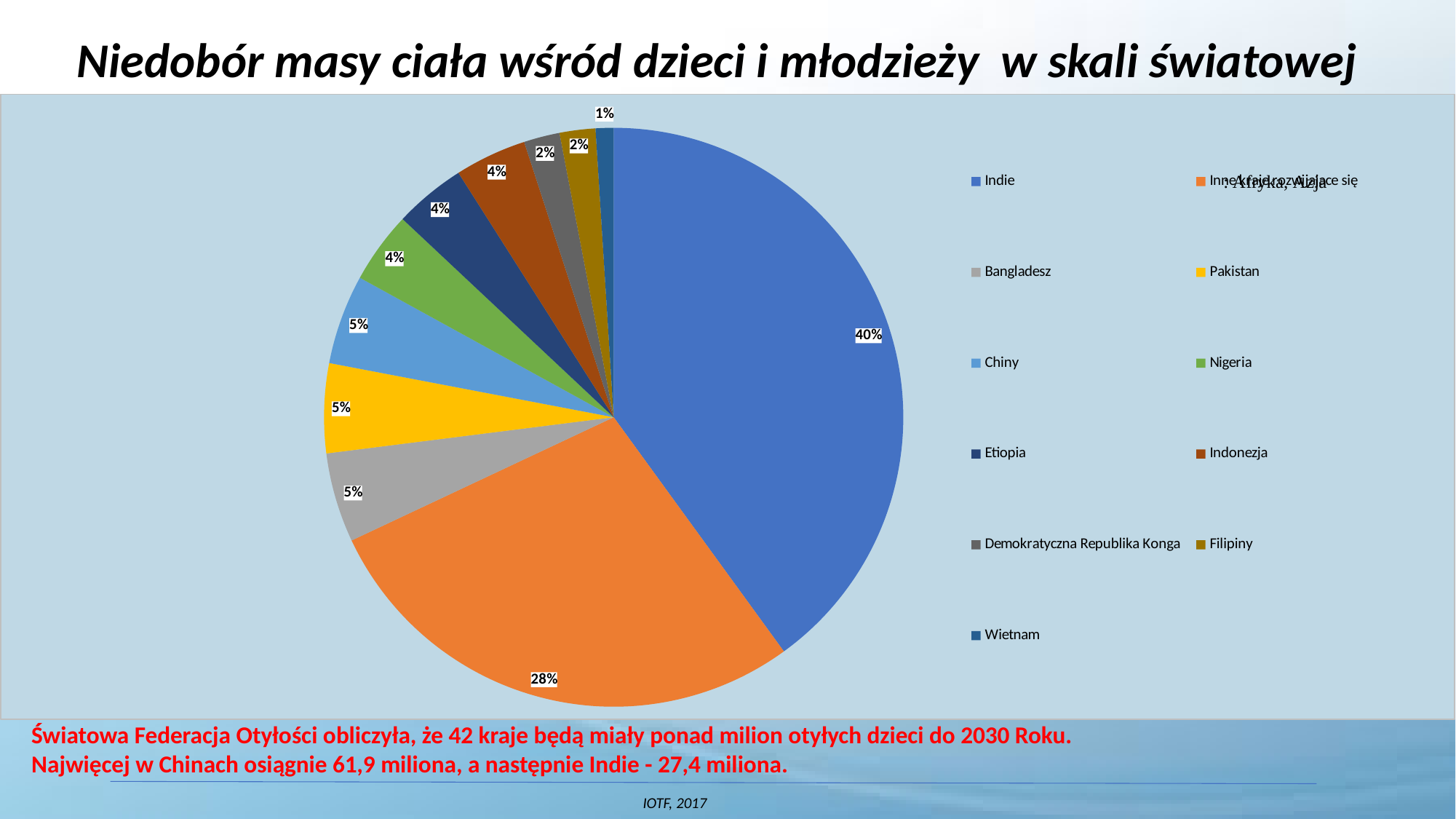
What share of the pie does Filipiny account for? 2% What percentage is shown for Chiny in the pie chart? 5% What percentage is shown for Wietnam? 1% What type of chart is shown on the slide? Pie chart What is the title of the slide containing the chart? Niedobór masy ciała wśród dzieci i młodzieży w skali światowej Which category has the largest slice of the pie chart? Indie What percentage is shown for Nigeria? 4% Which category has the smallest slice of the pie chart? Wietnam What percentage of the pie chart does Indie represent? 40% Which slice is larger: Indie or Pakistan? Indie What is the difference in percentage points between the Indie slice (40%) and the orange 'Inne kraje rozwijające się' slice (28%)? 12 percentage points How many categories are shown in the pie chart? 11